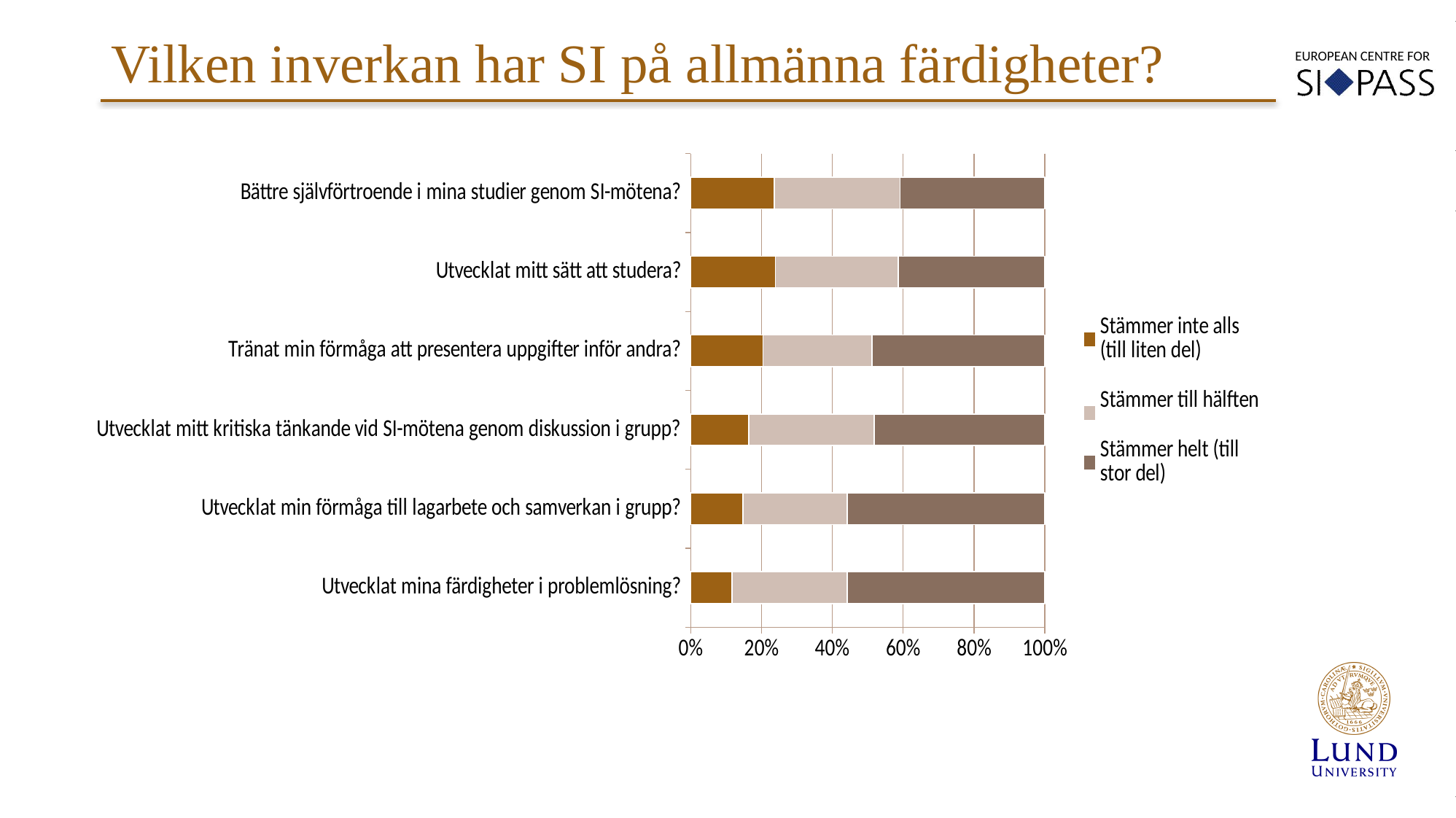
Is the 'Stämmer inte alls (till liten del)' share for 'Bättre självförtroende i mina studier genom SI-mötena?' greater or less than 20%? greater How many series does the legend list? 3 What value does each stacked bar reach on the x axis? 100% What is the highest tick value shown on the x axis? 100% Which has the larger 'Stämmer helt (till stor del)' share: 'Utvecklat min förmåga till lagarbete och samverkan i grupp?' or 'Bättre självförtroende i mina studier genom SI-mötena?' Utvecklat min förmåga till lagarbete och samverkan i grupp? Is the 'Stämmer helt (till stor del)' share for 'Utvecklat min förmåga till lagarbete och samverkan i grupp?' greater or less than 40%? greater Which legend entry is shown in the darkest (grey-brown) colour? Stämmer helt (till stor del) How many categories (statements) are plotted in the chart? 6 What is the title of the slide containing the chart? Vilken inverkan har SI på allmänna färdigheter? What kind of chart is shown on the slide? Stacked bar chart Which has the larger 'Stämmer inte alls (till liten del)' share: 'Bättre självförtroende i mina studier genom SI-mötena?' or 'Utvecklat mina färdigheter i problemlösning?' Bättre självförtroende i mina studier genom SI-mötena? Is the 'Stämmer inte alls (till liten del)' share for 'Utvecklat mina färdigheter i problemlösning?' greater or less than 20%? less